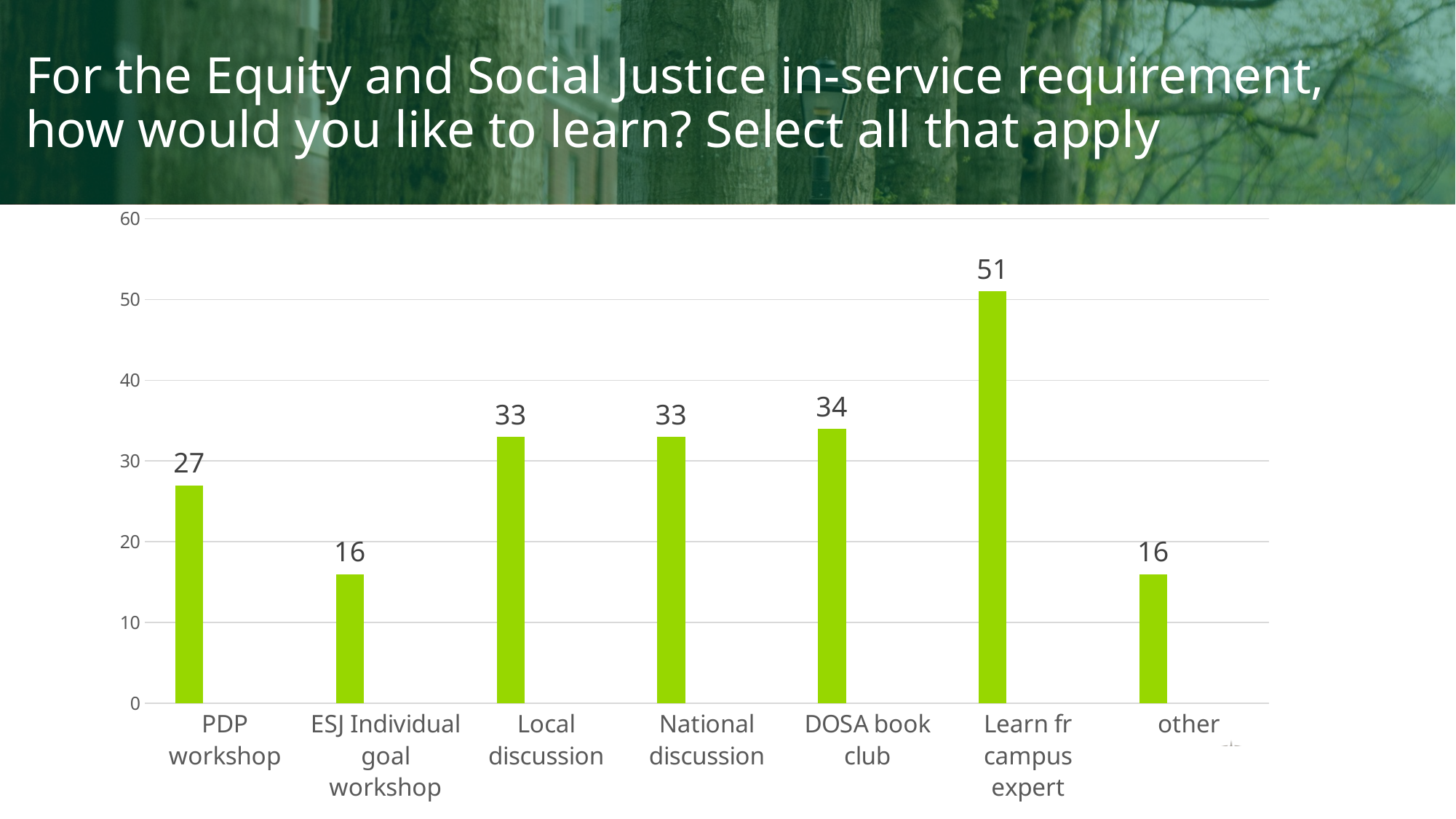
Which category has the highest value? Learn fr campus expert What kind of chart is shown on the slide? bar chart Which is larger, the value for PDP workshop or the value for Local discussion? Local discussion What is the difference between the values for Learn fr campus expert and DOSA book club? 17 What is the value for PDP workshop? 27 What is the value for ESJ Individual goal workshop? 16 What is the value for Learn fr campus expert? 51 How many categories are shown on the x axis? 7 What is the value for DOSA book club? 34 What is the value for National discussion? 33 Is the value for Learn fr campus expert greater or less than 50? greater What is the difference between the values for PDP workshop and other? 11